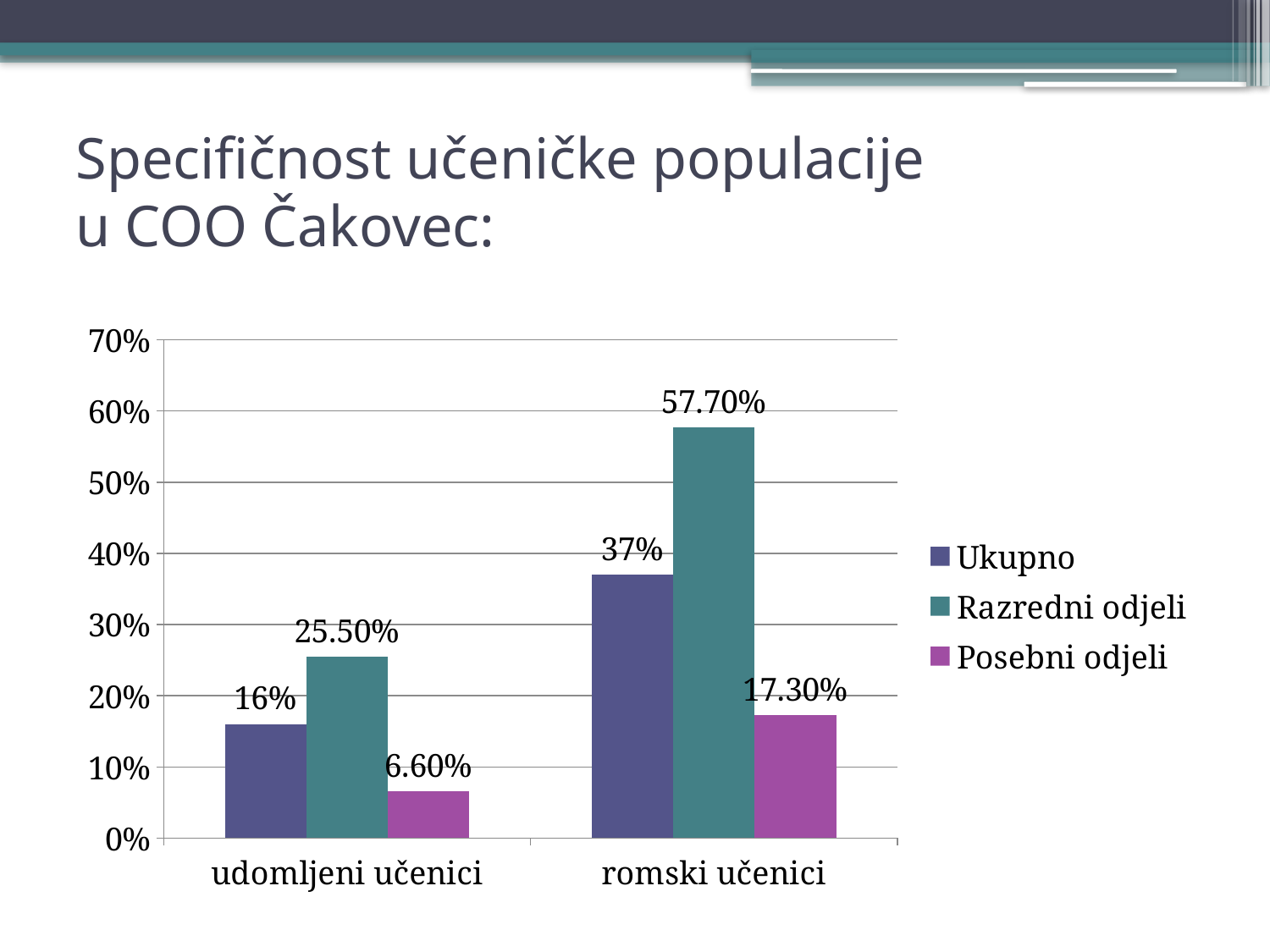
How many series does the legend list? 3 How many categories are shown on the x axis? 2 What is the difference between the Razredni odjeli values for romski učenici and udomljeni učenici? 32.20% What is the value for Ukupno in the udomljeni učenici category? 16% What kind of chart is shown on the slide? bar chart Which is larger: the Ukupno value for romski učenici or the Razredni odjeli value for udomljeni učenici? Ukupno value for romski učenici Which series has the lowest value in the udomljeni učenici category? Posebni odjeli Is the Ukupno value for romski učenici greater or less than 40%? less Which series has the highest value in the romski učenici category? Razredni odjeli What is the value for Razredni odjeli in the romski učenici category? 57.70% What is the value for Posebni odjeli in the udomljeni učenici category? 6.60% What is the value for Posebni odjeli in the romski učenici category? 17.30%